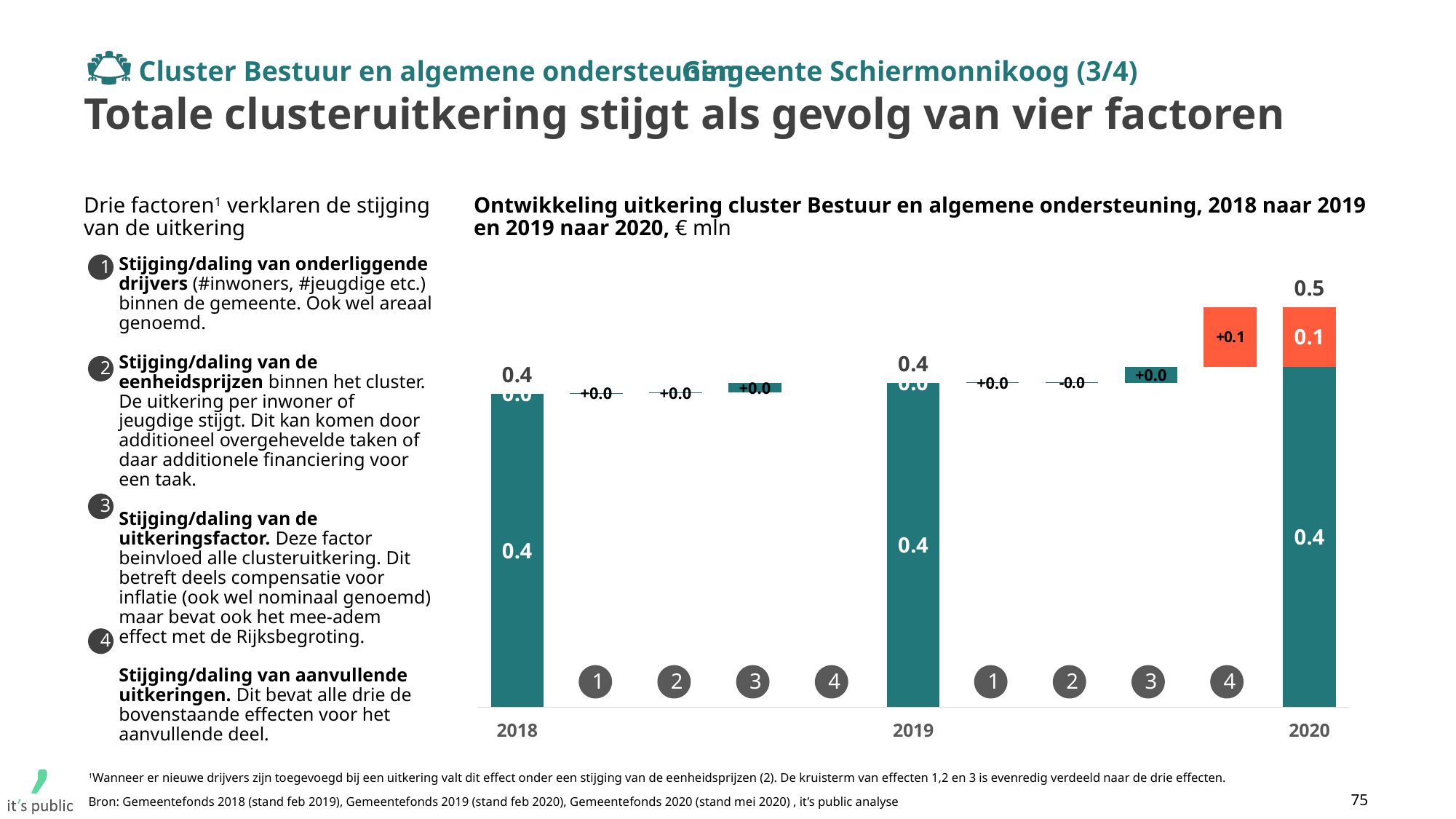
What is the value labelled on the factor 4 bar between 2019 and 2020? +0.1 Do the year totals rise or fall from 2018 to 2020? rise Which year has the highest total value: 2018, 2019 or 2020? 2020 In what unit are the values in the chart expressed, according to the chart title? € mln What is the value of the teal segment in the 2020 bar? 0.4 What is the total value shown above the bar for 2018? 0.4 What is the total value shown above the bar for 2020? 0.5 What is the difference between the total for 2020 and the total for 2019? 0.1 How many year totals (2018, 2019, 2020) are shown in the chart? 3 Is the total for 2020 larger or smaller than the total for 2018? larger What is the value labelled on the factor 2 bar between 2019 and 2020? -0.0 What is the value of the orange segment in the 2020 bar? 0.1